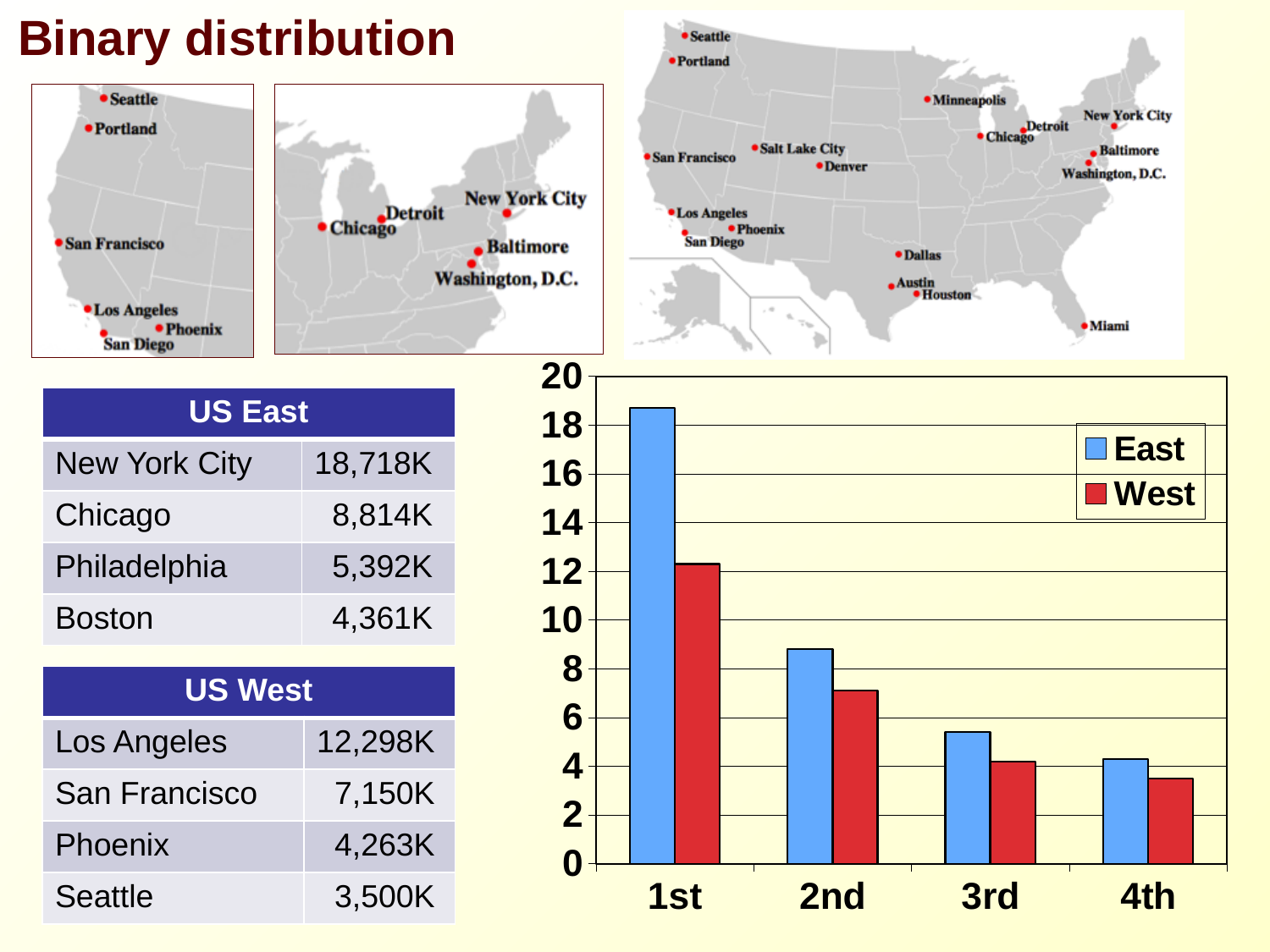
For the 2nd category, which is larger, East or West? East Which category has the highest East value? 1st How many series does the chart's legend list? 2 Do the East values rise or fall from 1st to 4th? fall Is the East value for 2nd greater or less than 8? greater Which category has the lowest West value? 4th What colour are the West bars in the chart? red How many categories are shown on the x axis of the chart? 4 What kind of chart is shown on the slide? bar chart Is the East value for 1st greater or less than 18? greater Is the West value for 3rd greater or less than 6? less